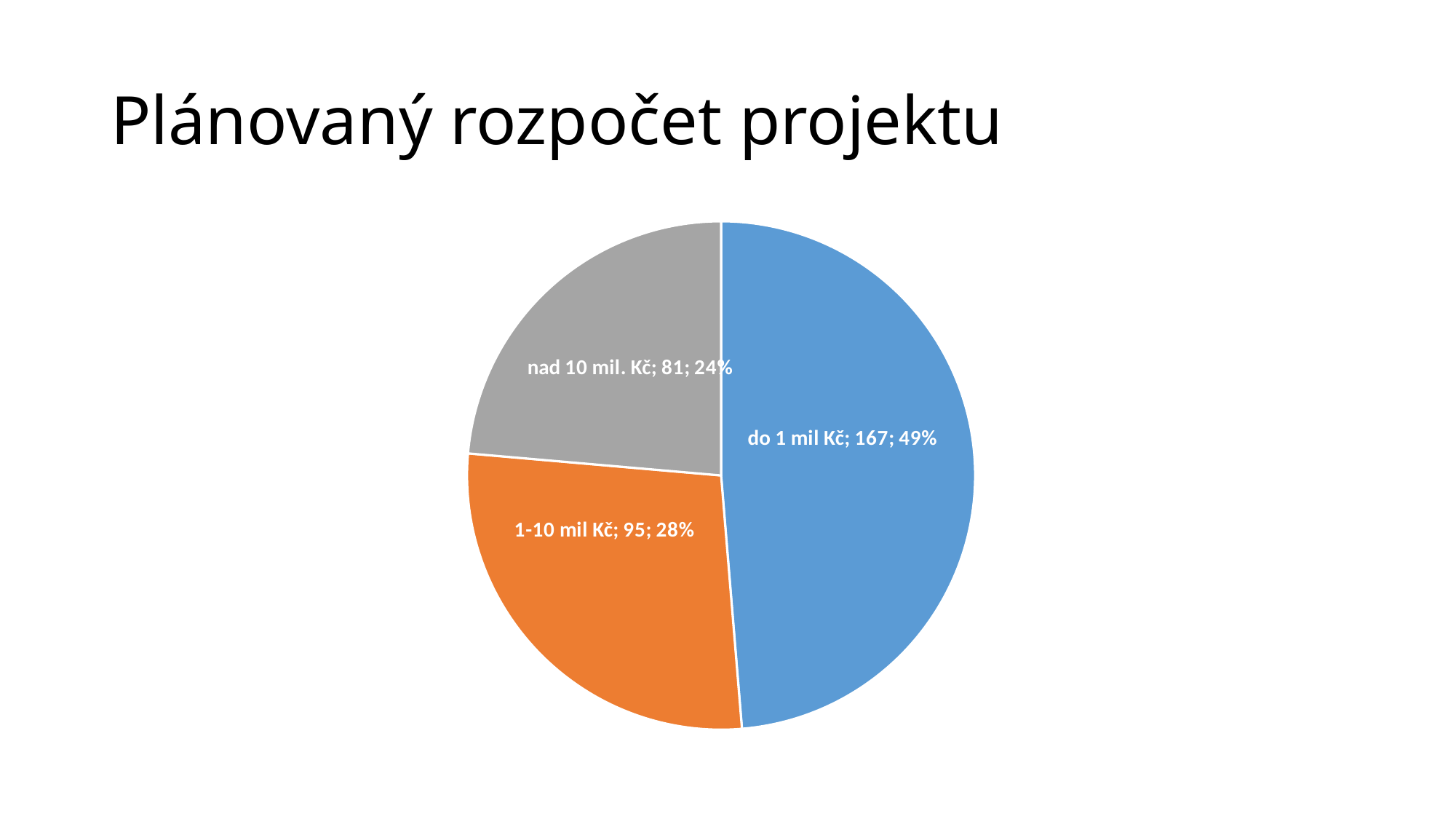
What is the count for the '1-10 mil Kč' slice? 95 Which is larger, the count for '1-10 mil Kč' or for 'nad 10 mil. Kč'? 1-10 mil Kč What share of the pie does the 'do 1 mil Kč' slice represent? 49% What is the count for the 'nad 10 mil. Kč' slice? 81 Which category has the smallest slice? nad 10 mil. Kč What is the difference between the counts for 'do 1 mil Kč' and '1-10 mil Kč'? 72 What is the count for the 'do 1 mil Kč' slice? 167 What kind of chart is shown on the slide? pie chart Which category has the largest slice? do 1 mil Kč What is the title of the slide? Plánovaný rozpočet projektu What share of the pie does the 'nad 10 mil. Kč' slice represent? 24% How many slices does the pie chart have? 3